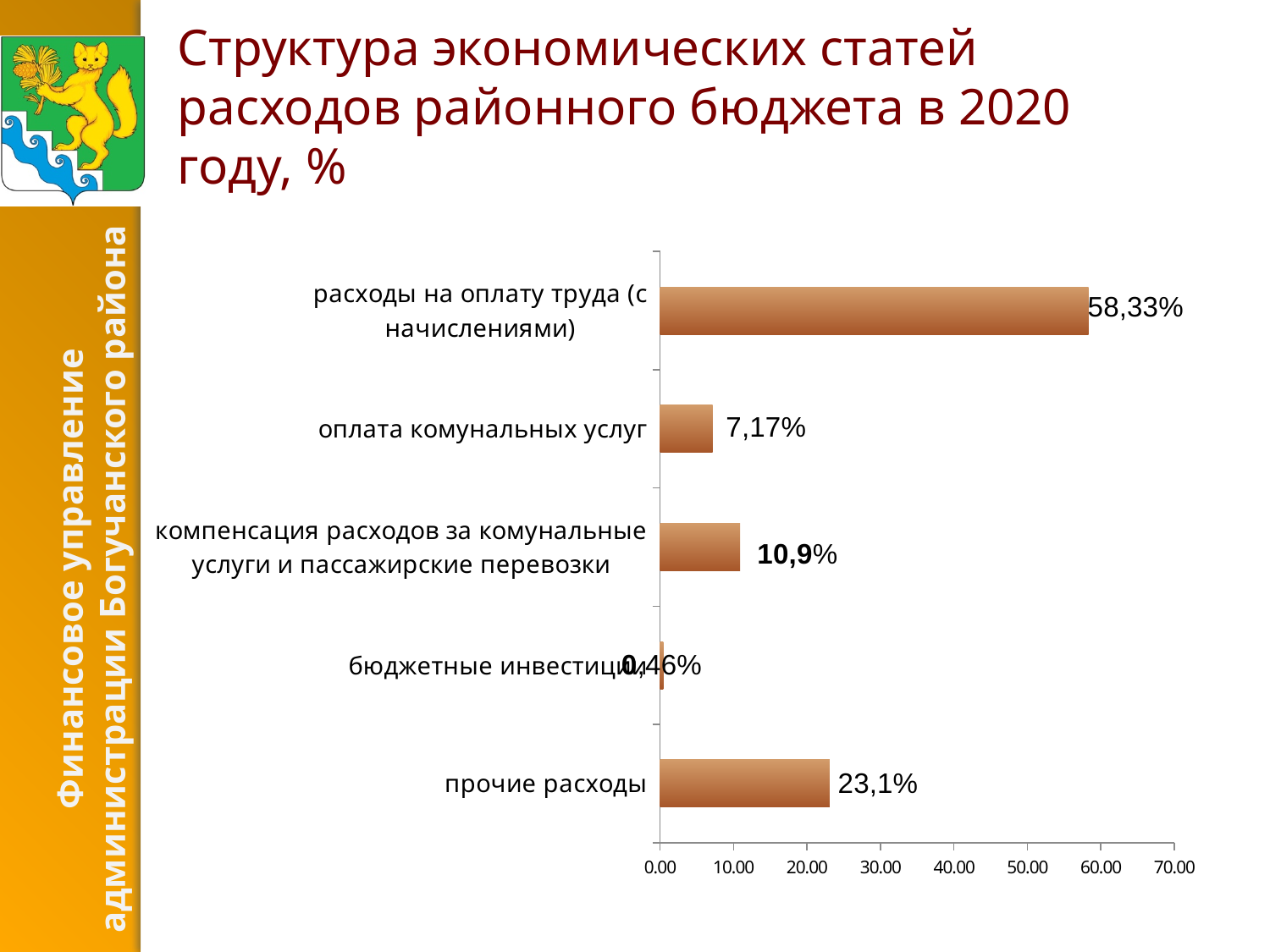
What kind of chart is shown on the slide? bar chart What is the value for «прочие расходы»? 23,1% Which category has the highest value? расходы на оплату труда (с начислениями) How many categories are shown in the chart? 5 Which is larger: «оплата комунальных услуг» or «компенсация расходов за комунальные услуги и пассажирские перевозки»? компенсация расходов за комунальные услуги и пассажирские перевозки What is the value for «компенсация расходов за комунальные услуги и пассажирские перевозки»? 10,9% What is the value for «бюджетные инвестиции»? 0,46% Is the value for «прочие расходы» greater or less than 20.00? greater What is the difference between «расходы на оплату труда (с начислениями)» and «прочие расходы»? 35,23% What is the value for «расходы на оплату труда (с начислениями)»? 58,33% What is the value for «оплата комунальных услуг»? 7,17% Which category has the lowest value? бюджетные инвестиции